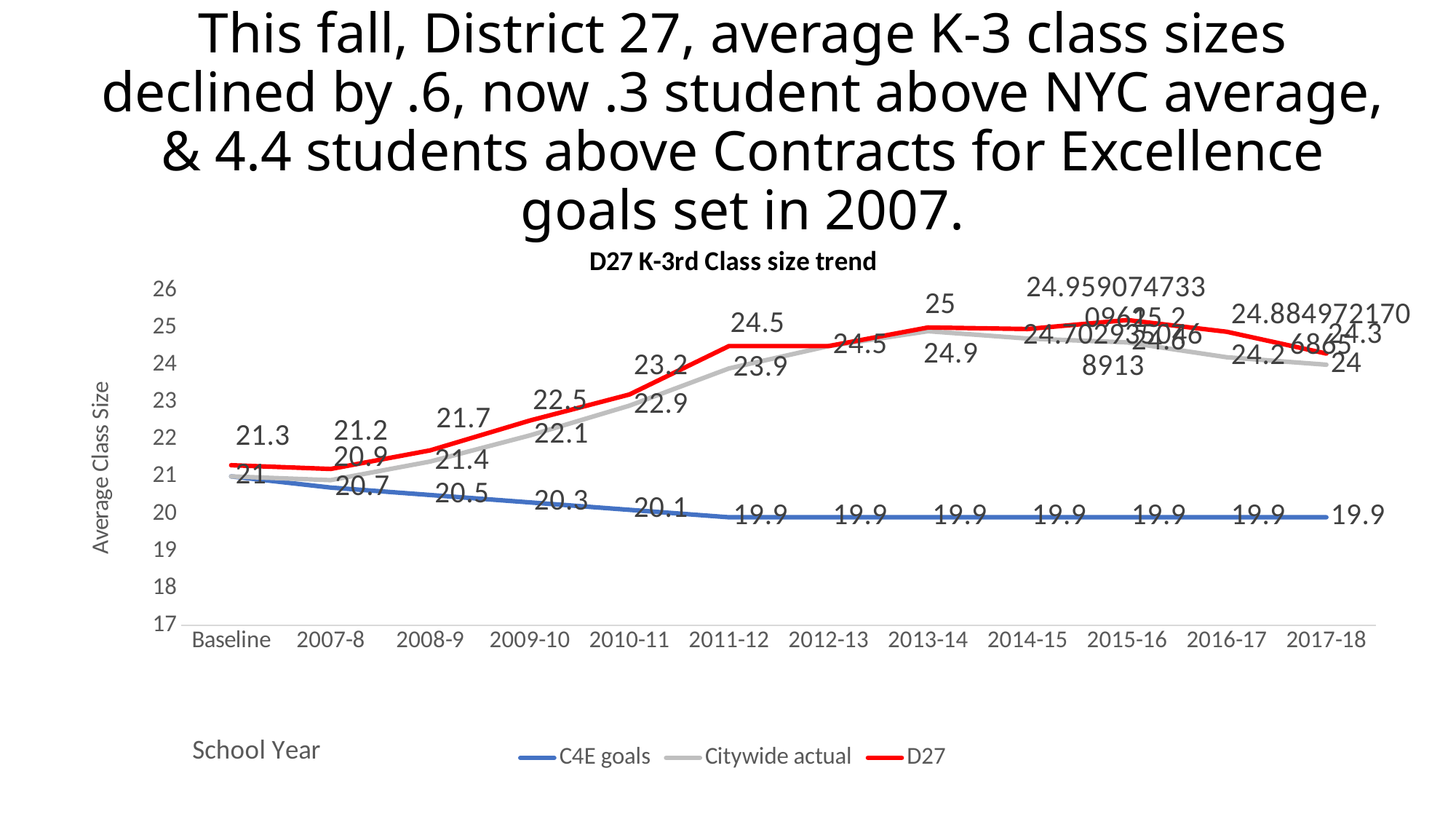
How many series does the legend of the D27 K-3rd Class size trend chart list? 3 Do the C4E goals values rise or fall from Baseline to 2011-12? fall What is the D27 value for 2011-12? 24.5 What is the C4E goals value for 2017-18? 19.9 In 2011-12, which is larger: the D27 value or the Citywide actual value? D27 What is the title of the y axis of the chart? Average Class Size What is the D27 value at Baseline? 21.3 What is the difference between the D27 value and the C4E goals value in 2017-18? 4.4 How many school-year categories are shown on the x axis of the chart? 12 What is the difference between the D27 value and the Citywide actual value in 2017-18? 0.3 What kind of chart is shown on the slide? line chart What is the Citywide actual value for 2017-18? 24